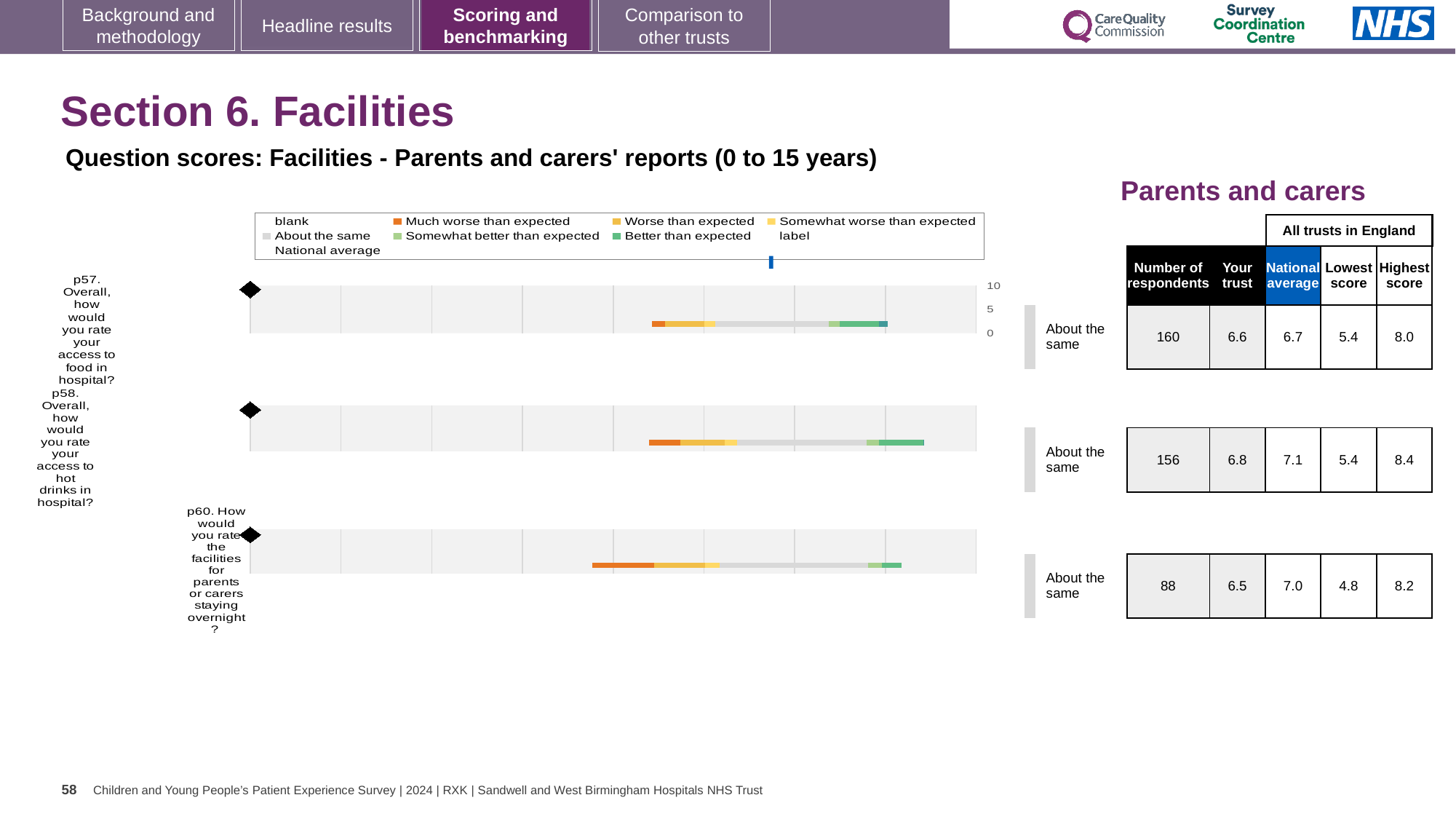
Which question has the lowest 'Lowest score' across all trusts in England? p60 For p58, what is the difference between the highest score and the lowest score across all trusts in England? 3.0 What is the national average score for p58 (access to hot drinks in hospital)? 7.1 For p60, which is larger: the 'Your trust' score or the national average? National average Which legend entry is shown in orange? Much worse than expected Which question has the highest 'Your trust' score? p58 How many respondents answered p60 (facilities for parents or carers staying overnight)? 88 What is the 'Your trust' score for p57 (access to food in hospital)? 6.6 What benchmark category is shown for p57? About the same How many questions (bars) are shown in the Facilities chart? 3 What kind of chart is used to show the question scores for Facilities? bar chart What is the highest score across all trusts in England for p57? 8.0